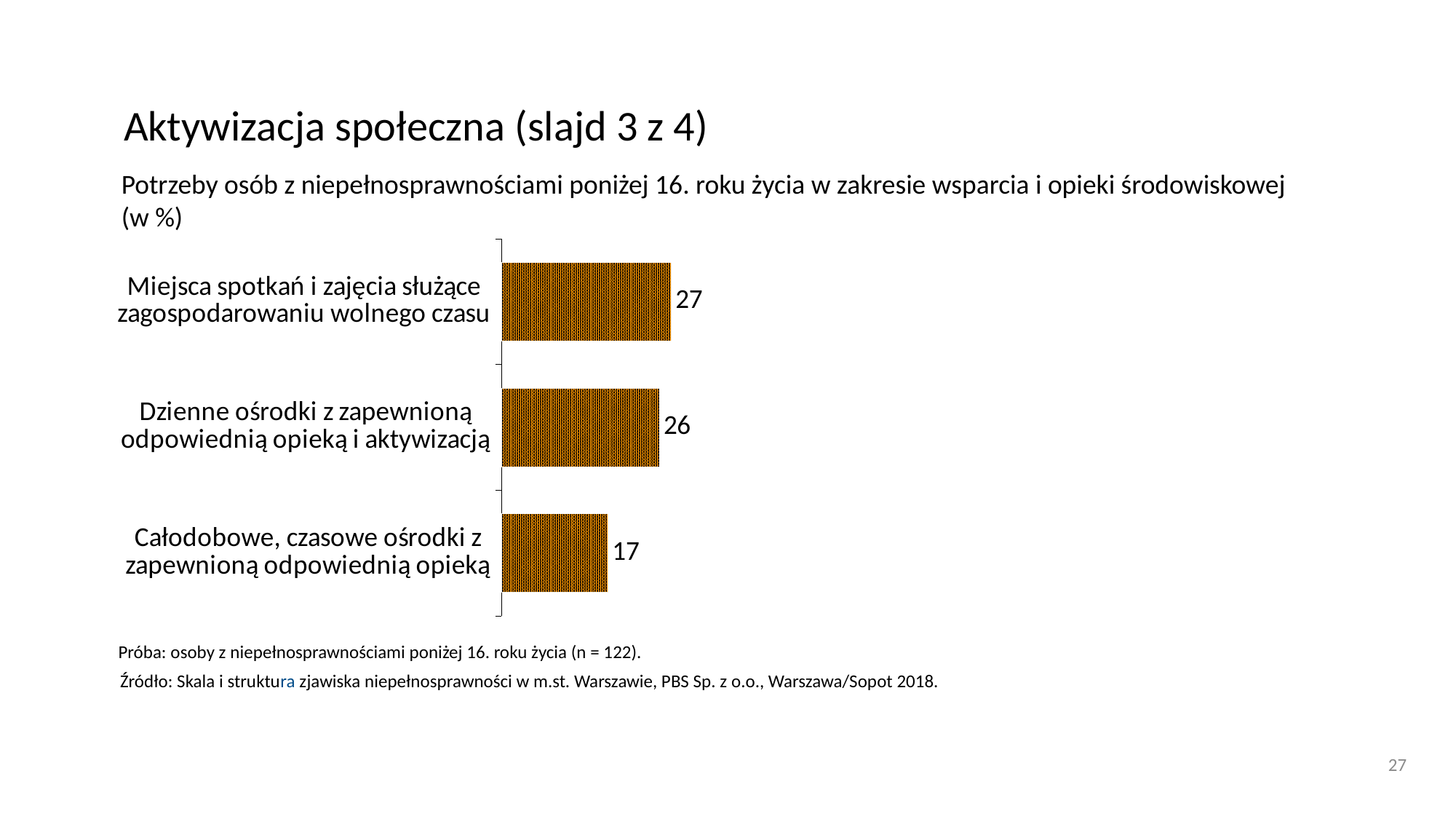
What is the value for "Całodobowe, czasowe ośrodki z zapewnioną odpowiednią opieką"? 17 Which category has the highest value? Miejsca spotkań i zajęcia służące zagospodarowaniu wolnego czasu What is the sample size (n) stated below the chart? 122 In what unit are the chart values expressed, according to the chart title? % What is the value for "Dzienne ośrodki z zapewnioną odpowiednią opieką i aktywizacją"? 26 What is the difference between the values for "Dzienne ośrodki z zapewnioną odpowiednią opieką i aktywizacją" and "Całodobowe, czasowe ośrodki z zapewnioną odpowiednią opieką"? 9 Which is larger: the value for "Dzienne ośrodki z zapewnioną odpowiednią opieką i aktywizacją" or for "Całodobowe, czasowe ośrodki z zapewnioną odpowiednią opieką"? Dzienne ośrodki z zapewnioną odpowiednią opieką i aktywizacją What is the value for "Miejsca spotkań i zajęcia służące zagospodarowaniu wolnego czasu"? 27 What kind of chart is shown on the slide? Bar chart Which category has the lowest value? Całodobowe, czasowe ośrodki z zapewnioną odpowiednią opieką What is the difference between the values for "Miejsca spotkań i zajęcia służące zagospodarowaniu wolnego czasu" and "Całodobowe, czasowe ośrodki z zapewnioną odpowiednią opieką"? 10 How many categories are shown in the chart? 3